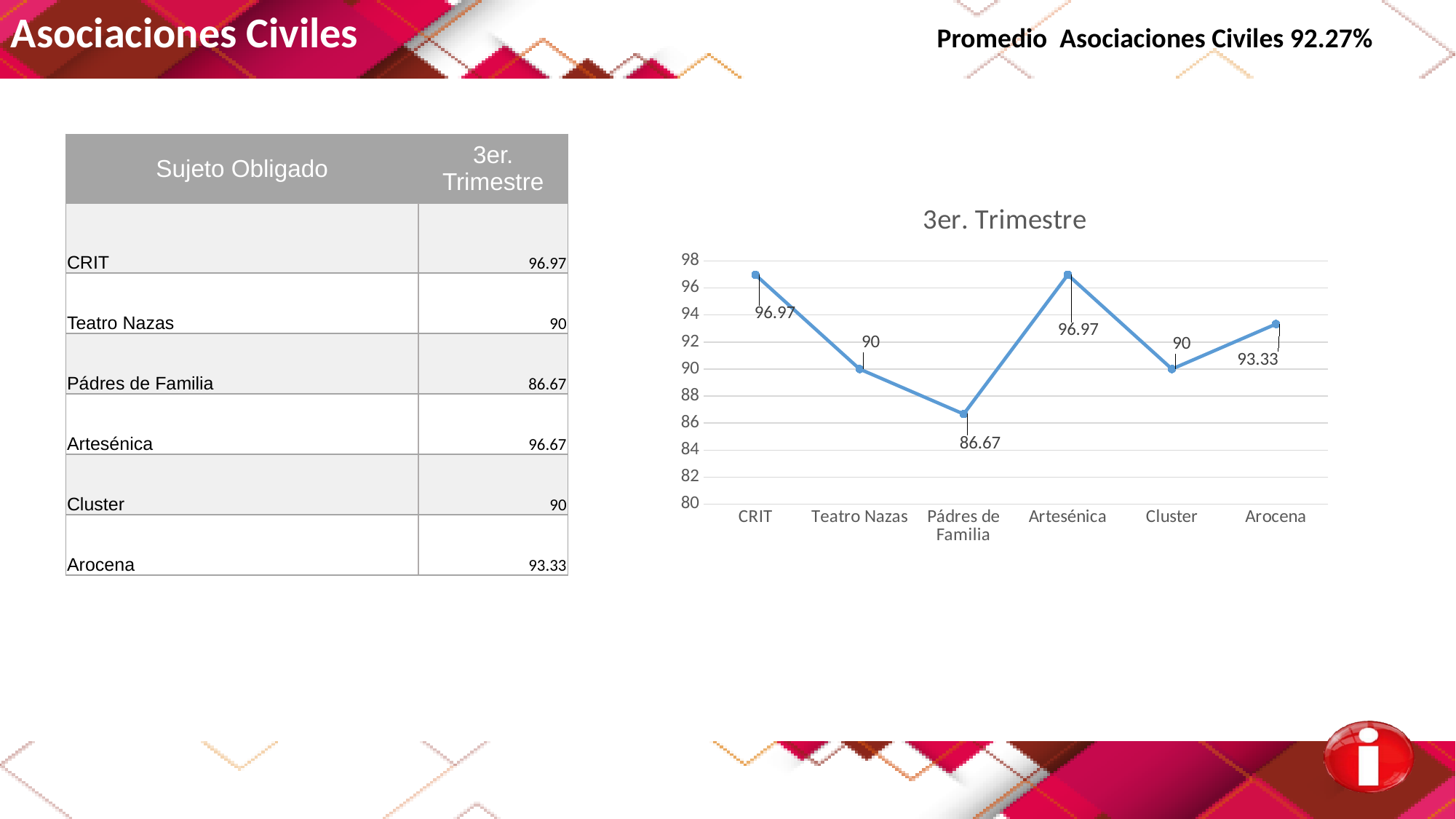
Which is larger, the value for Arocena or the value for Cluster? Arocena What is the value for Arocena in the chart? 93.33 What is the value for Teatro Nazas in the chart? 90 What type of chart is shown on the slide? line chart What is the value for Pádres de Familia in the chart? 86.67 Does the value rise or fall from Cluster to Arocena? rise Is the value for Pádres de Familia greater or less than 88? less What is the value for CRIT in the chart? 96.97 Which category has the lowest value in the chart? Pádres de Familia What is the title of the chart? 3er. Trimestre What is the difference between the values for CRIT and Pádres de Familia? 10.3 How many categories are plotted on the x axis of the chart? 6